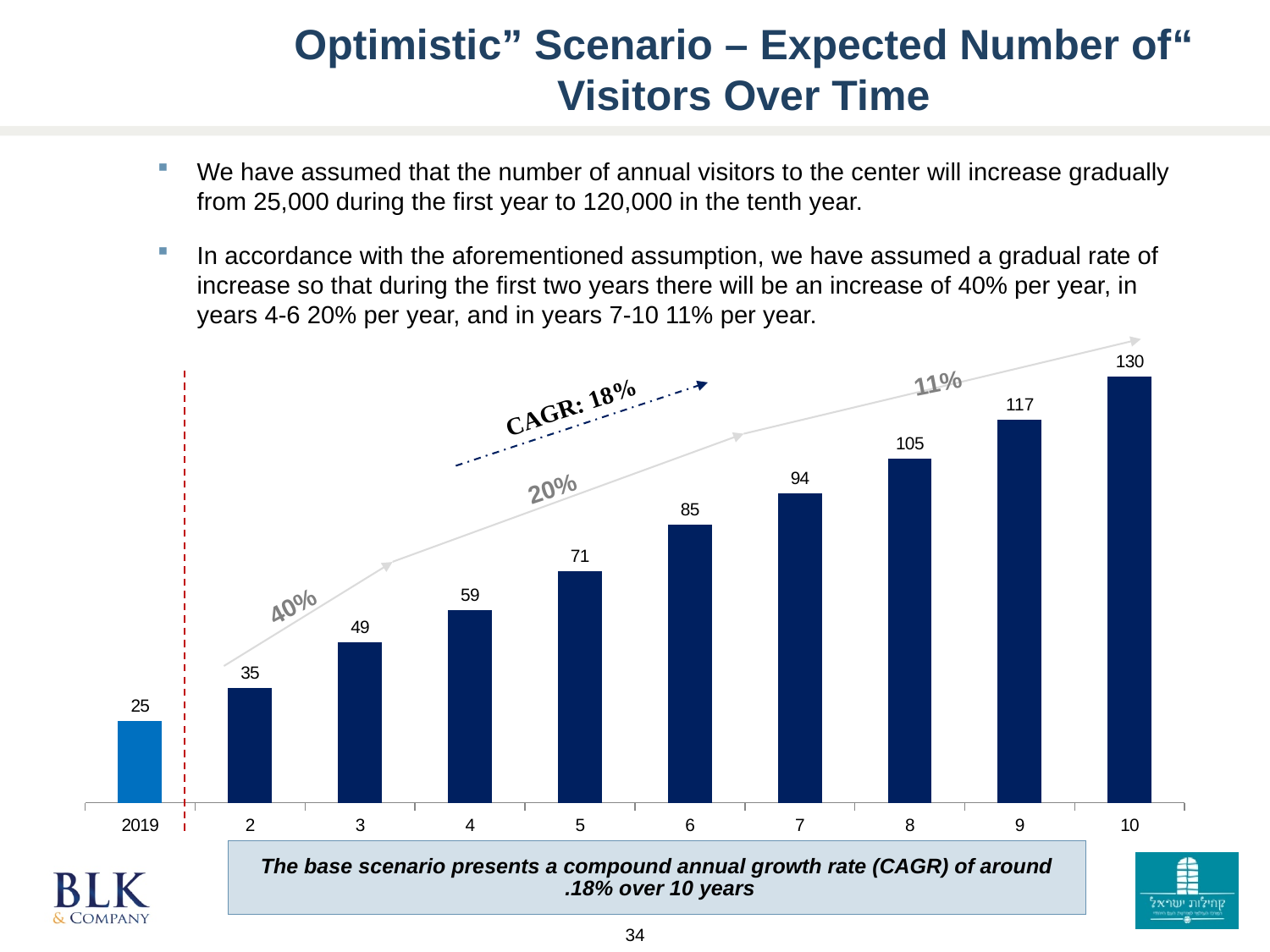
What is the difference between the values for year 5 and year 4? 12 Do the values rise or fall from 2019 to year 10? rise What CAGR is labelled on the chart? 18% Which is larger, the value for year 7 or the value for year 8? year 8 What is the value shown for 2019? 25 What kind of chart is shown on the slide? bar chart What is the value shown for year 6? 85 Which category has the lowest value? 2019 How many bars are shown in the chart? 10 Which category has the highest value? 10 What is the difference between the values for year 10 and 2019? 105 What is the value shown for year 10? 130